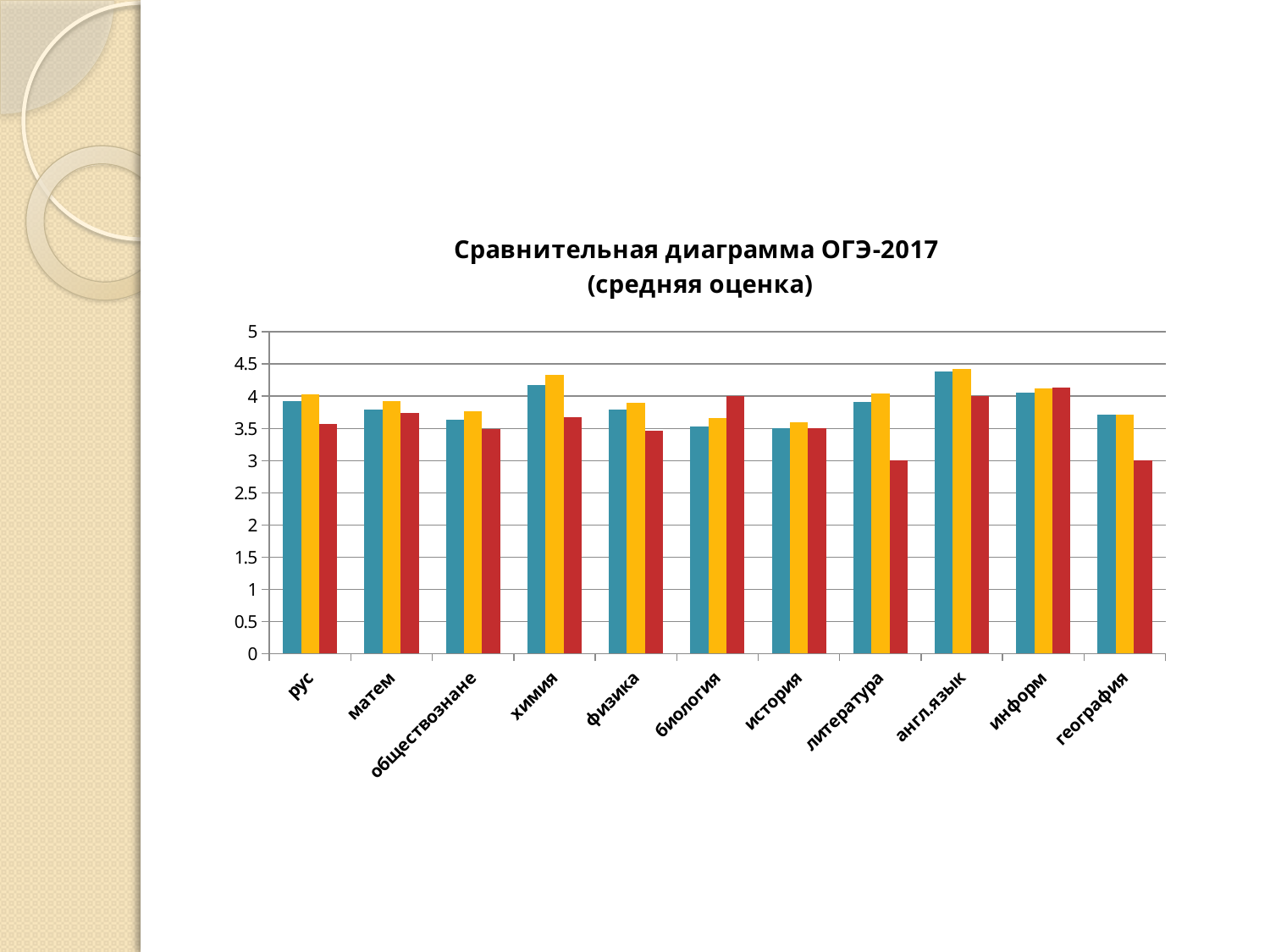
Is the value of the red bar for литература greater or less than 3.5? less Is the value of the blue bar for история greater or less than 4? less What is the title of the chart? Сравнительная диаграмма ОГЭ-2017 (средняя оценка) What kind of chart is shown on the slide? bar chart For биология, which is larger: the red bar or the blue bar? the red bar Is the value of the blue bar for химия greater or less than 4? greater How many subject categories are shown on the x axis? 11 For литература, which is larger: the blue bar or the red bar? the blue bar How many bars are plotted for each subject category? 3 Which subject has the highest blue bar? англ.язык